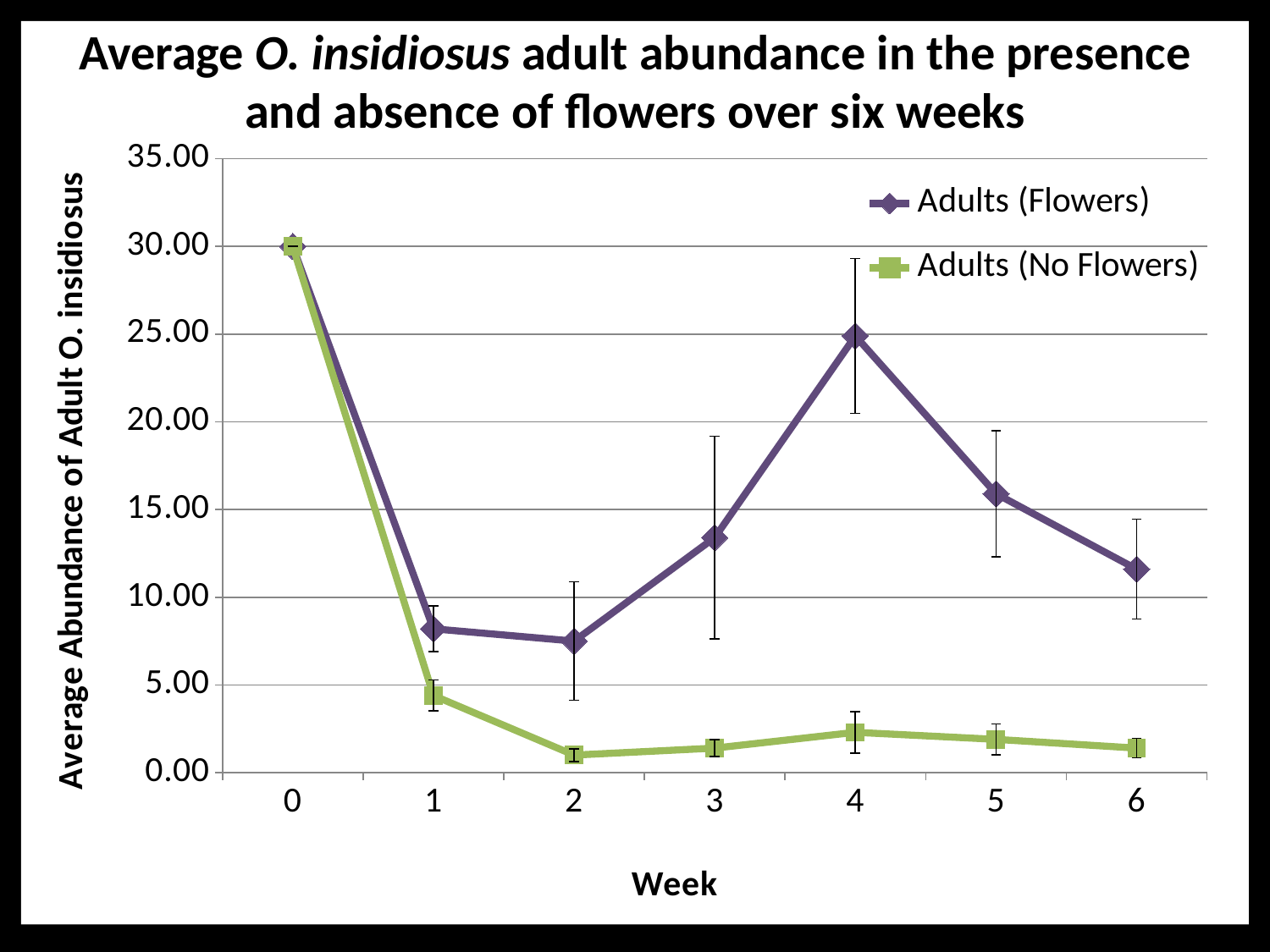
Is the value for Adults (Flowers) at week 5 greater or less than 20.00? less Is the value for Adults (Flowers) at week 4 greater or less than 20.00? greater At week 4, which series has the higher value, Adults (Flowers) or Adults (No Flowers)? Adults (Flowers) How many series does the legend list? 2 How many weeks are plotted along the x axis? 7 What is the value for Adults (No Flowers) at week 0? 30.00 Is the value for Adults (Flowers) at week 1 greater or less than 10.00? less What kind of chart is shown on the slide? line chart Does the Adults (No Flowers) series rise or fall from week 0 to week 2? fall What is the value for Adults (Flowers) at week 0? 30.00 Excluding week 0, at which week is the Adults (Flowers) series highest? Week 4